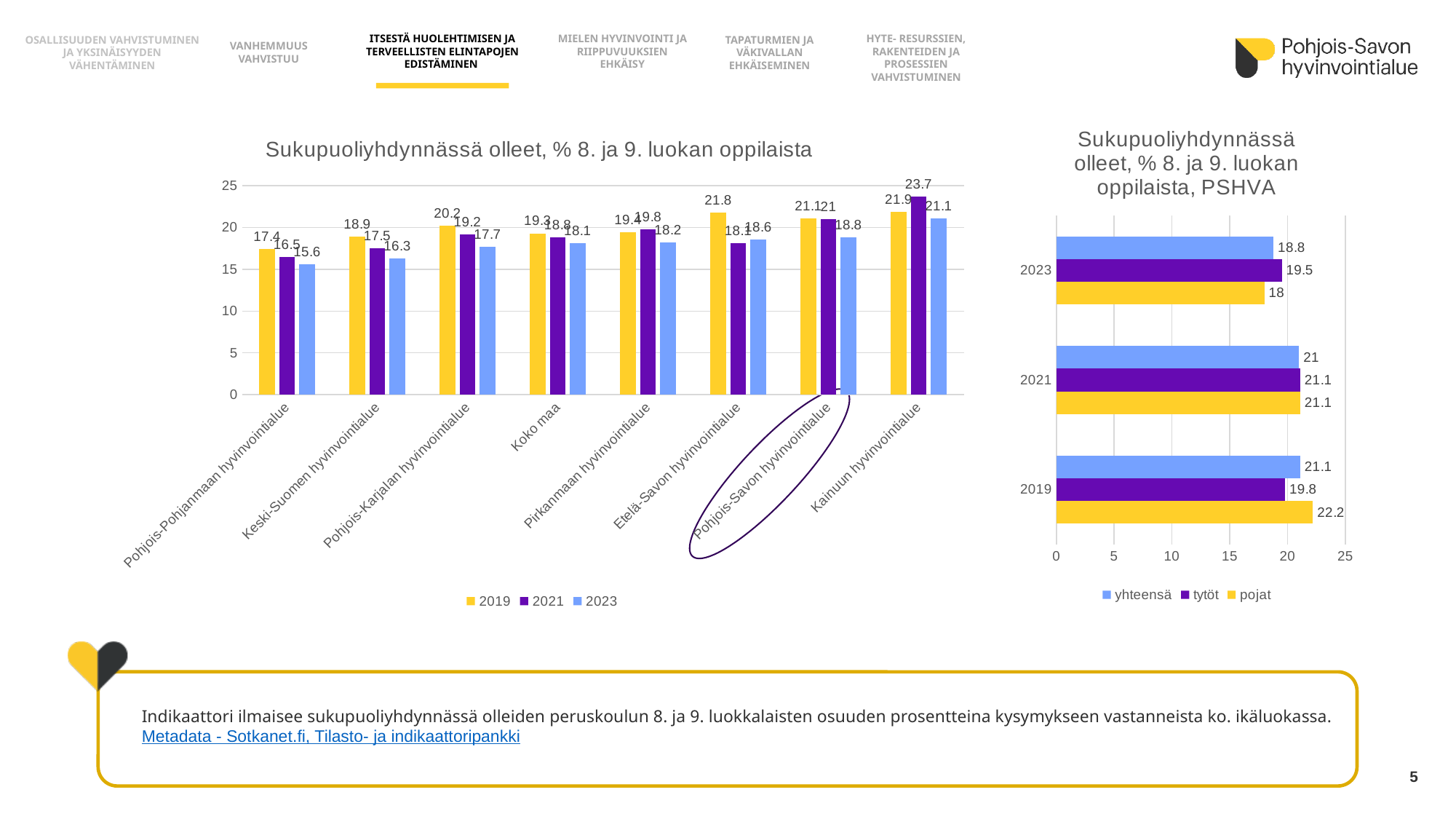
In the left chart, what is the 2023 value for Pohjois-Savon hyvinvointialue? 18.8 In the left chart, which category has the highest 2021 value? Kainuun hyvinvointialue In the right chart, what is the tytöt value for 2023? 19.5 How many series does the legend of the left chart list? 3 In the left chart, which category has the lowest 2023 value? Pohjois-Pohjanmaan hyvinvointialue What kind of chart is the right chart (PSHVA)? Bar chart In the left chart, what is the difference between the 2019 and 2023 values for Etelä-Savon hyvinvointialue? 3.2 In the right chart, what is the difference between the pojat values for 2019 and 2023? 4.2 In the left chart, which is larger for Pirkanmaan hyvinvointialue: the 2019 value or the 2021 value? 2021 How many categories are shown on the x axis of the left chart? 8 In the right chart 'Sukupuoliyhdynnässä olleet, % 8. ja 9. luokan oppilaista, PSHVA', what is the pojat value for 2019? 22.2 In the left chart 'Sukupuoliyhdynnässä olleet, % 8. ja 9. luokan oppilaista', what is the 2019 value for Koko maa? 19.3